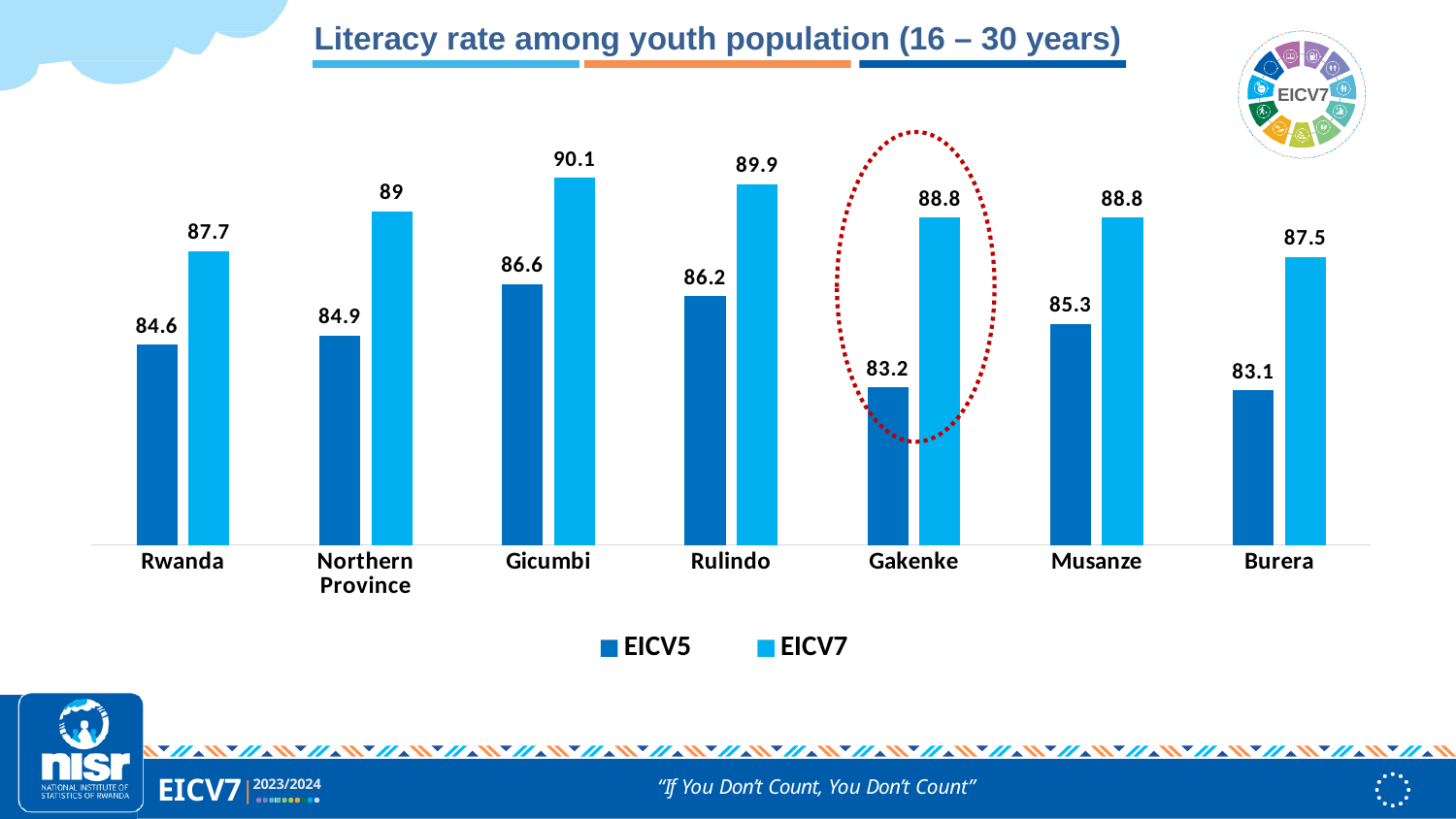
Which is larger, the EICV5 value for Rulindo or the EICV5 value for Musanze? Rulindo What is the EICV7 literacy rate for Gicumbi? 90.1 What is the EICV5 literacy rate for Gakenke? 83.2 What kind of chart is shown on the slide? Bar chart Which category is highlighted with a red dotted circle? Gakenke What is the EICV7 literacy rate for Rwanda? 87.7 How many categories are shown on the x axis? 7 What is the difference between the EICV7 and EICV5 values for Gakenke? 5.6 Which category has the lowest EICV5 value? Burera How many series does the legend list? 2 What is the title of the chart? Literacy rate among youth population (16 – 30 years) Which category has the highest EICV7 value? Gicumbi